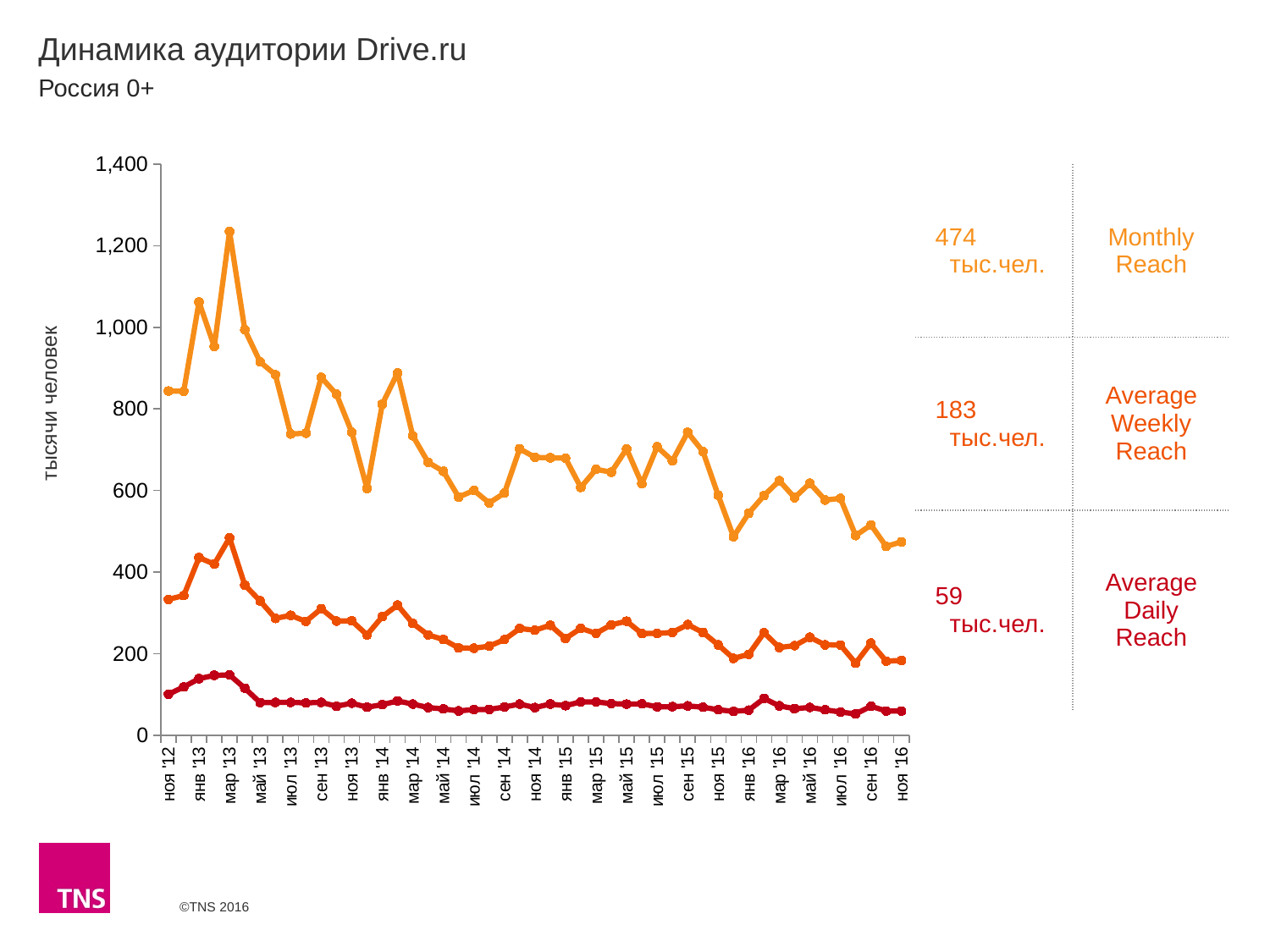
Is the Average Daily Reach value in мар '13 greater or less than 200? less What is the Monthly Reach value shown for the latest period (ноя '16)? 474 тыс.чел. What is the Average Weekly Reach value shown for the latest period (ноя '16)? 183 тыс.чел. In which month does Monthly Reach reach its highest point? мар '13 Which series has the highest values throughout the chart? Monthly Reach What is the Average Daily Reach value shown for the latest period (ноя '16)? 59 тыс.чел. What is the difference between the latest Average Weekly Reach (183) and the latest Average Daily Reach (59)? 124 тыс.чел. What kind of chart is shown on the slide? line chart Is the Monthly Reach value at its peak in мар '13 greater or less than 1,200? greater Does Monthly Reach overall rise or fall from ноя '12 to ноя '16? fall What is the difference between the latest Monthly Reach (474) and the latest Average Weekly Reach (183)? 291 тыс.чел. How many series are plotted on the chart? 3